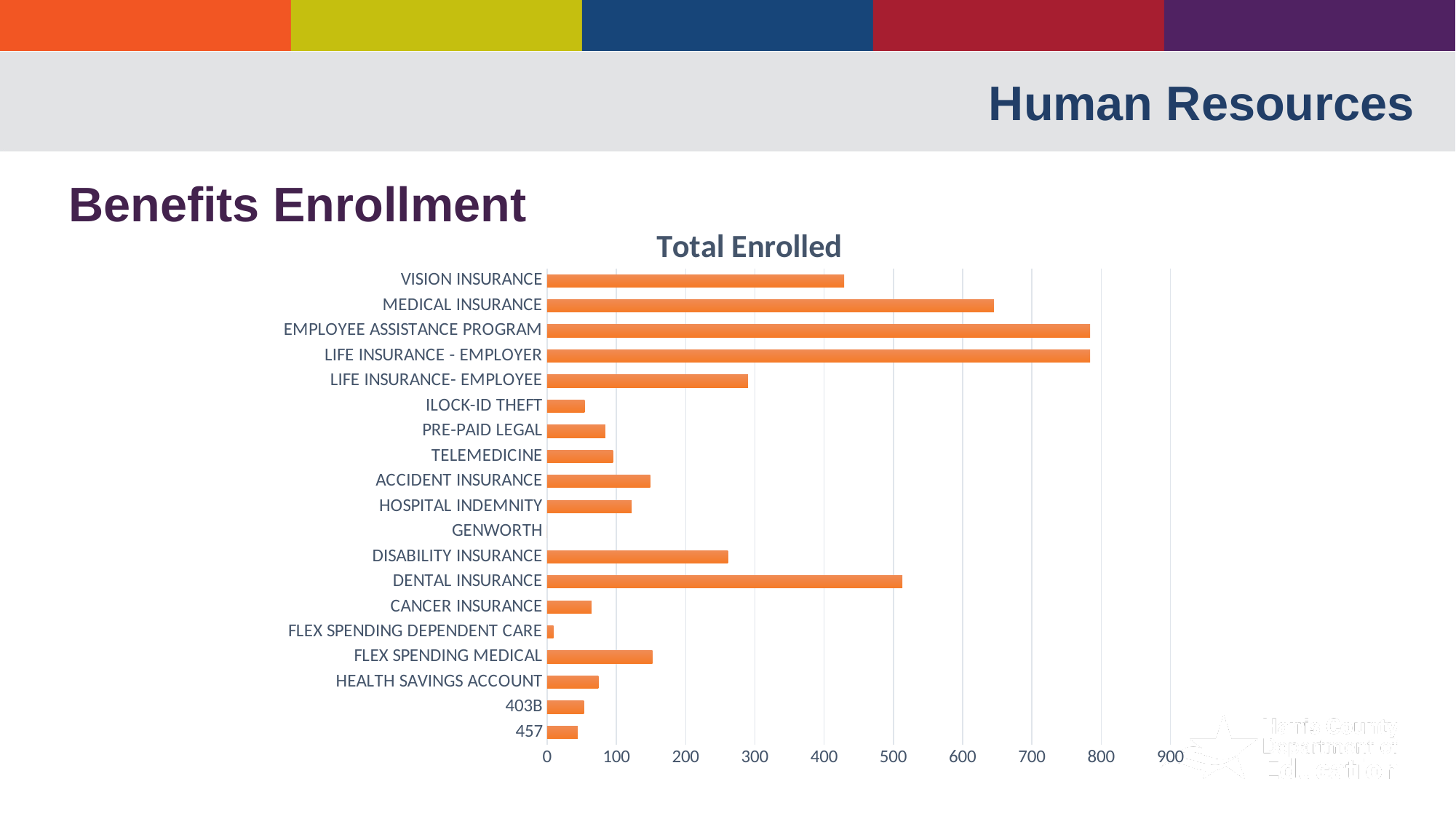
How many categories are listed on the chart's vertical axis? 19 Is the value for MEDICAL INSURANCE greater or less than 600? greater What colour are the bars in the chart? orange Is the value for VISION INSURANCE greater or less than 400? greater Is the value for FLEX SPENDING DEPENDENT CARE greater or less than 100? less What is the title of the chart? Total Enrolled Which category shows no visible bar on the chart? GENWORTH What kind of chart is shown on the slide? bar chart Which has a larger value, MEDICAL INSURANCE or DENTAL INSURANCE? MEDICAL INSURANCE Which has a larger value, VISION INSURANCE or LIFE INSURANCE- EMPLOYEE? VISION INSURANCE